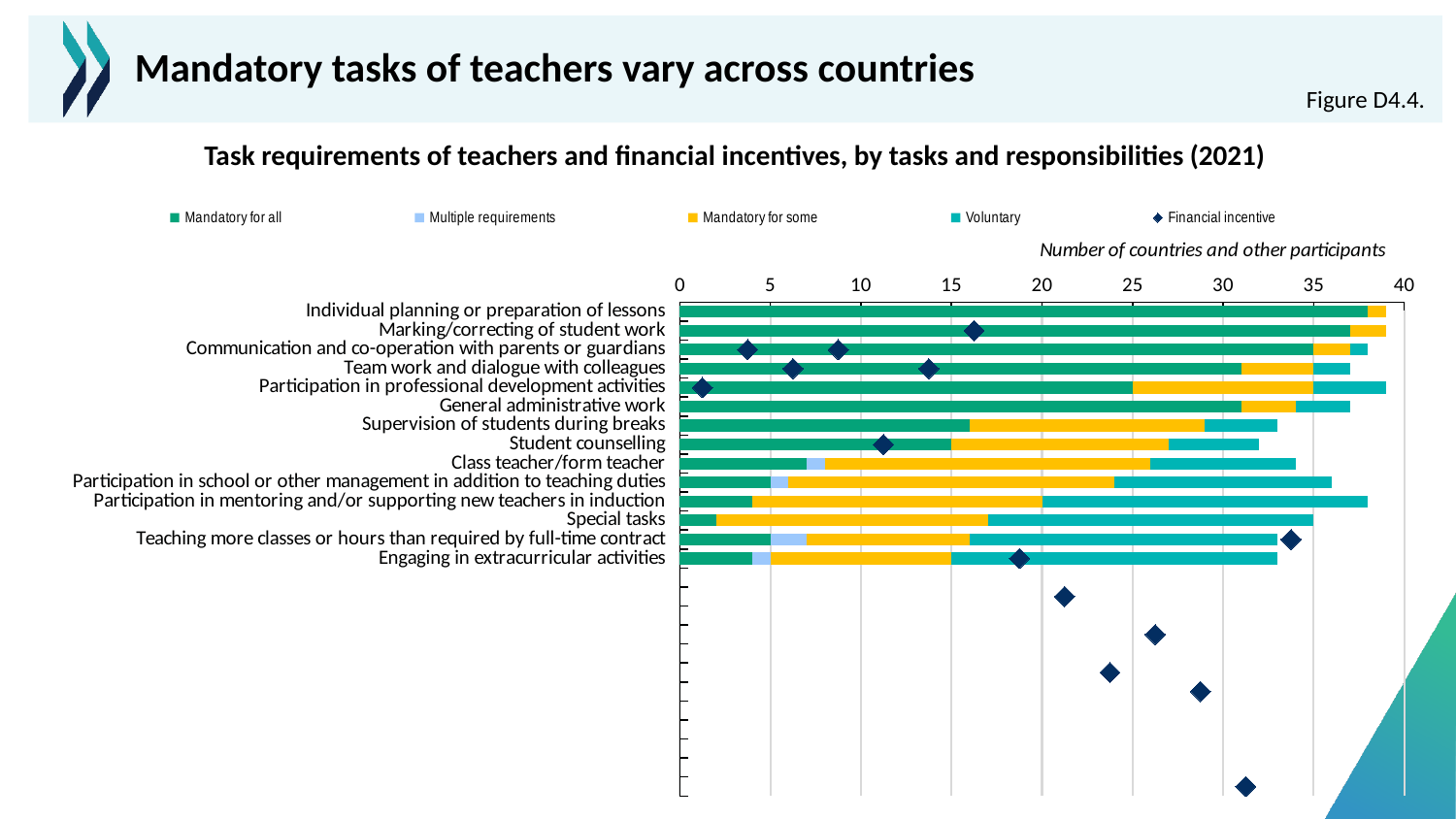
How many task categories are plotted on the vertical axis? 14 Is the 'Mandatory for all' value for 'Special tasks' greater or less than 5? less How many series does the legend list? 5 What does the horizontal axis measure, according to the axis label? Number of countries and other participants What kind of chart is shown on the slide? Stacked horizontal bar chart Which task has the smallest 'Mandatory for all' segment? Special tasks Which has the longer total bar: 'Participation in professional development activities' or 'Supervision of students during breaks'? Participation in professional development activities Is the 'Mandatory for all' value for 'Participation in professional development activities' greater or less than 20? greater Is the 'Mandatory for all' value for 'Supervision of students during breaks' greater or less than 10? greater Which has the larger 'Mandatory for all' value: 'Team work and dialogue with colleagues' or 'Supervision of students during breaks'? Team work and dialogue with colleagues What is the title of the chart? Task requirements of teachers and financial incentives, by tasks and responsibilities (2021)